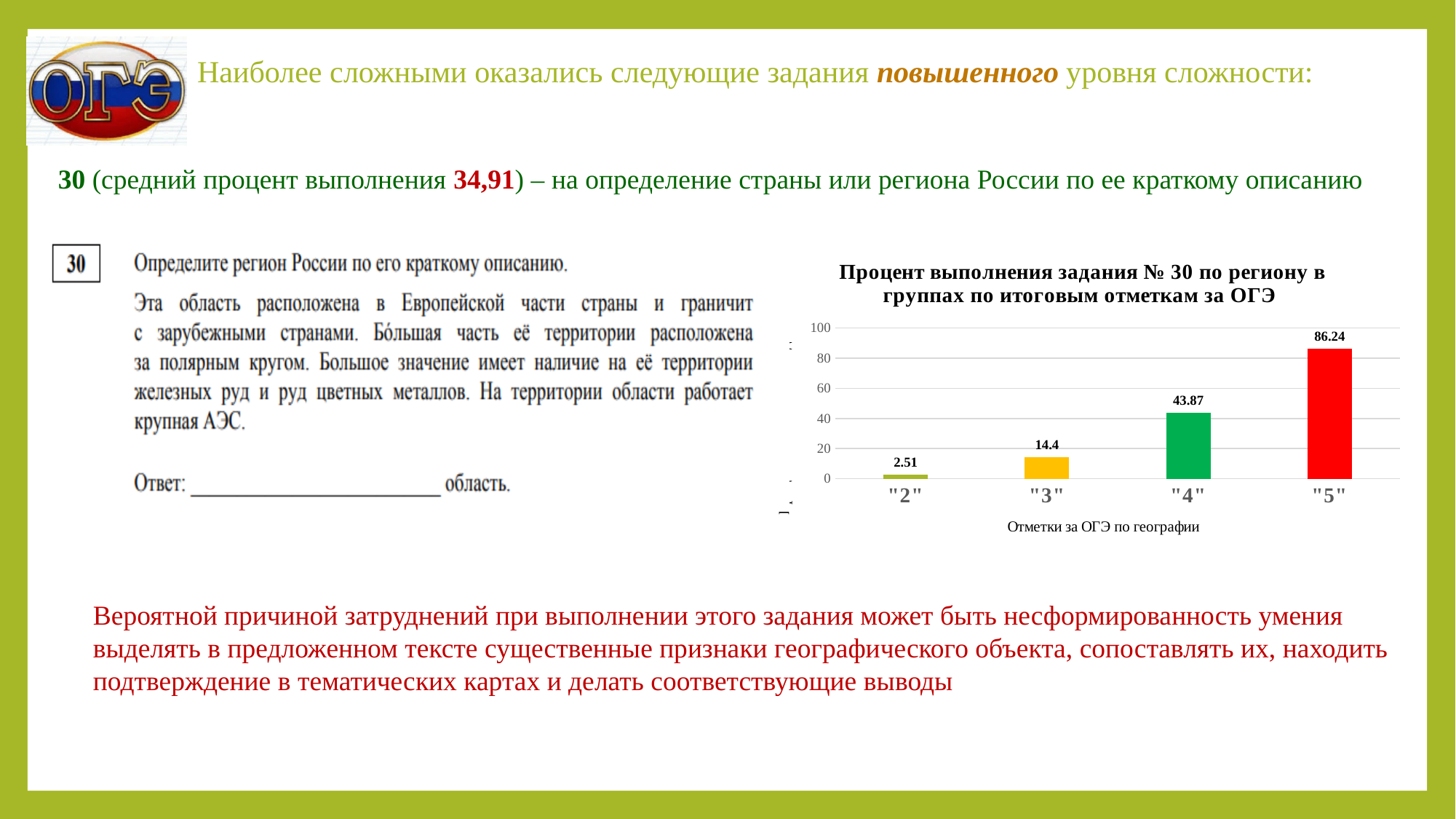
Do the values rise or fall as the grade increases from "2" to "5"? Rise What is the value for the "4" grade group in the chart? 43.87 What is the value for the "2" grade group in the chart? 2.51 Which grade group has the lowest completion percentage? "2" What is the x-axis label of the chart? Отметки за ОГЭ по географии What is the difference between the values for the "5" and "4" grade groups? 42.37 What is the value for the "5" grade group in the chart? 86.24 How many grade groups are shown on the x axis of the chart? 4 Which is larger, the value for the "3" group or the "4" group? "4" Which grade group has the highest completion percentage? "5" What is the value for the "3" grade group in the chart? 14.4 What kind of chart is shown on the slide? Bar chart